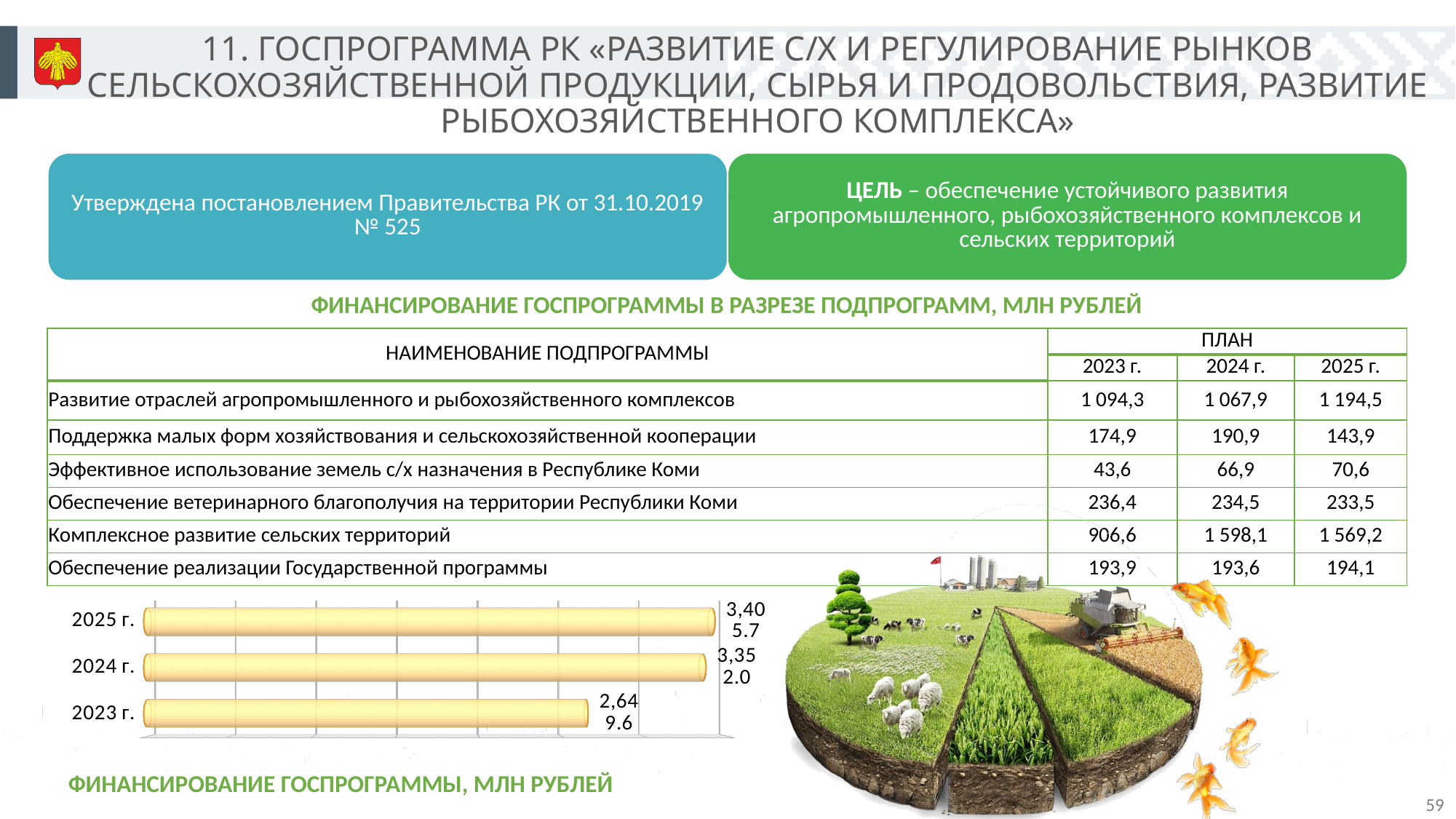
In the bar chart at the bottom left, which year has the lowest value? 2023 г. What kind of chart is shown at the bottom left of the slide? bar chart In the bar chart at the bottom left, what is the value labelled for 2023 г.? 2,649.6 What is the title printed under the bar chart at the bottom left? ФИНАНСИРОВАНИЕ ГОСПРОГРАММЫ, МЛН РУБЛЕЙ In the bar chart at the bottom left, which is larger: the value for 2024 г. or for 2023 г.? 2024 г. How many years (categories) are plotted in the bar chart at the bottom left? 3 In the bar chart at the bottom left, what is the difference between the values for 2025 г. and 2023 г.? 756.1 In the bar chart at the bottom left, what is the value labelled for 2024 г.? 3,352.0 In the bar chart at the bottom left, what is the value labelled for 2025 г.? 3,405.7 In the bar chart at the bottom left, do the values rise or fall from 2023 г. to 2025 г.? rise What colour are the bars in the bar chart at the bottom left? yellow In the bar chart at the bottom left, which year has the highest value? 2025 г.